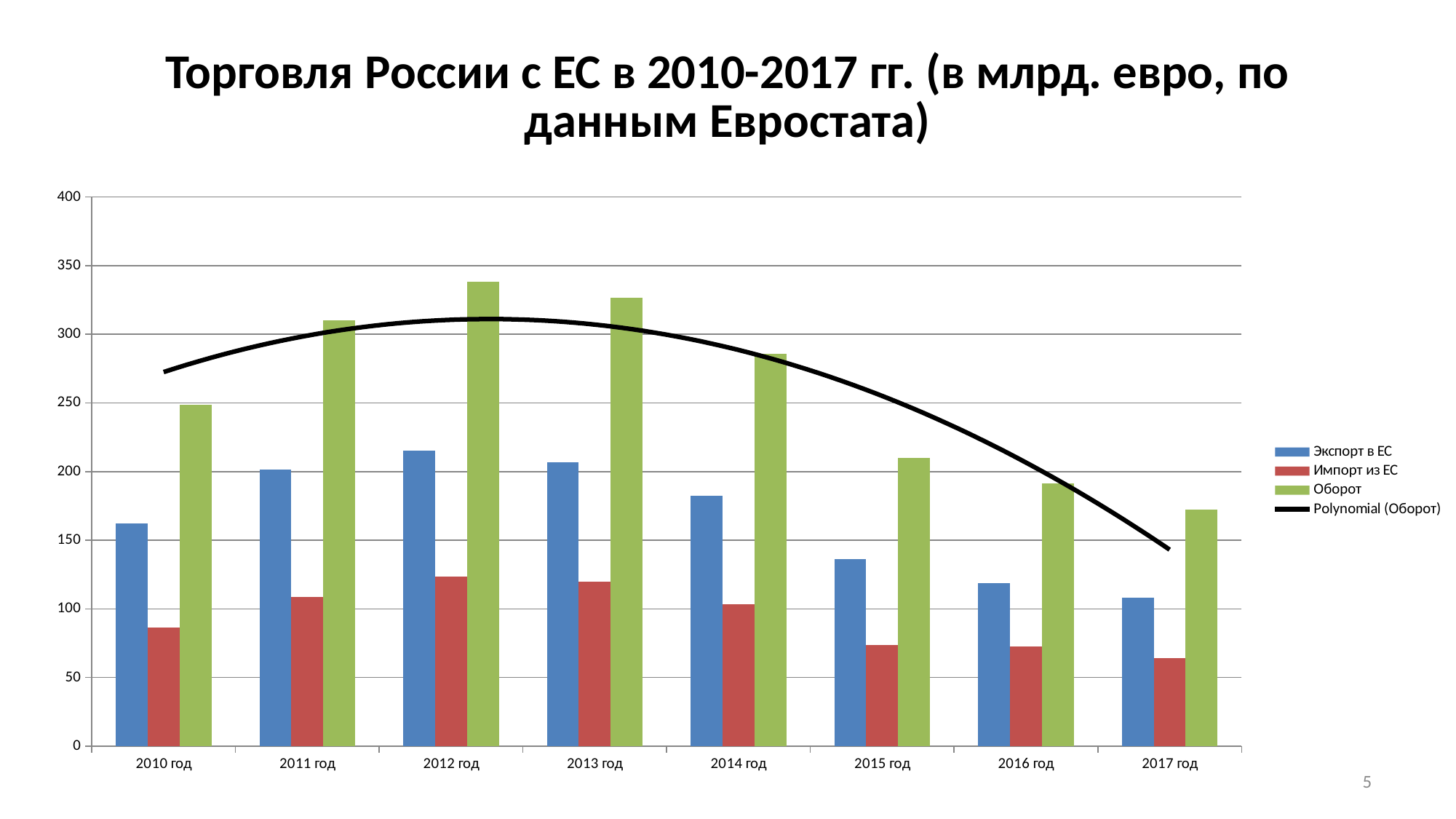
Is the value for Экспорт в ЕС in 2015 год greater or less than 150? less What kind of chart is shown on the slide? bar chart How many years are shown on the x axis? 8 In which year is Экспорт в ЕС lowest? 2017 год Which is larger: Экспорт в ЕС in 2011 год or Экспорт в ЕС in 2014 год? 2011 год In which year is Импорт из ЕС lowest? 2017 год How many series does the legend list? 4 In which year is Оборот lowest? 2017 год Does Оборот rise or fall from 2013 год to 2017 год? fall Is the value for Оборот in 2012 год greater or less than 300? greater Is the value for Импорт из ЕС in 2010 год greater or less than 100? less In which year is Оборот highest? 2012 год